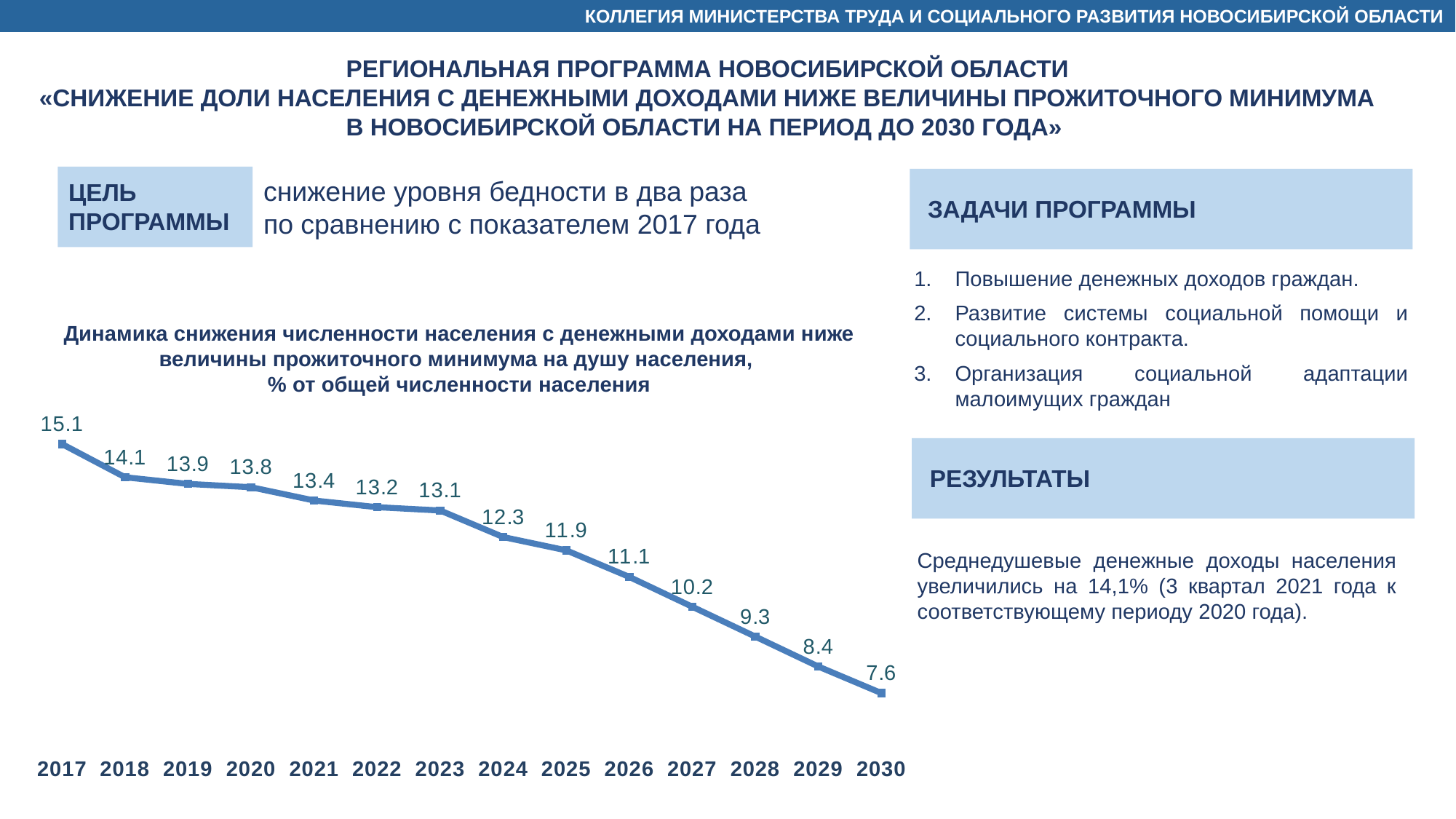
What is the value for 2024? 12.3 How many years are plotted on the chart? 14 What unit is stated in the chart title? % от общей численности населения What is the value for 2030? 7.6 What is the value for 2017? 15.1 Do the values rise or fall from 2017 to 2030? fall Which year has the highest value? 2017 What is the difference between the values for 2017 and 2030? 7.5 What is the difference between the values for 2025 and 2026? 0.8 What kind of chart is shown? line chart Which year has the lowest value? 2030 Which is larger, the value for 2021 or the value for 2027? 2021